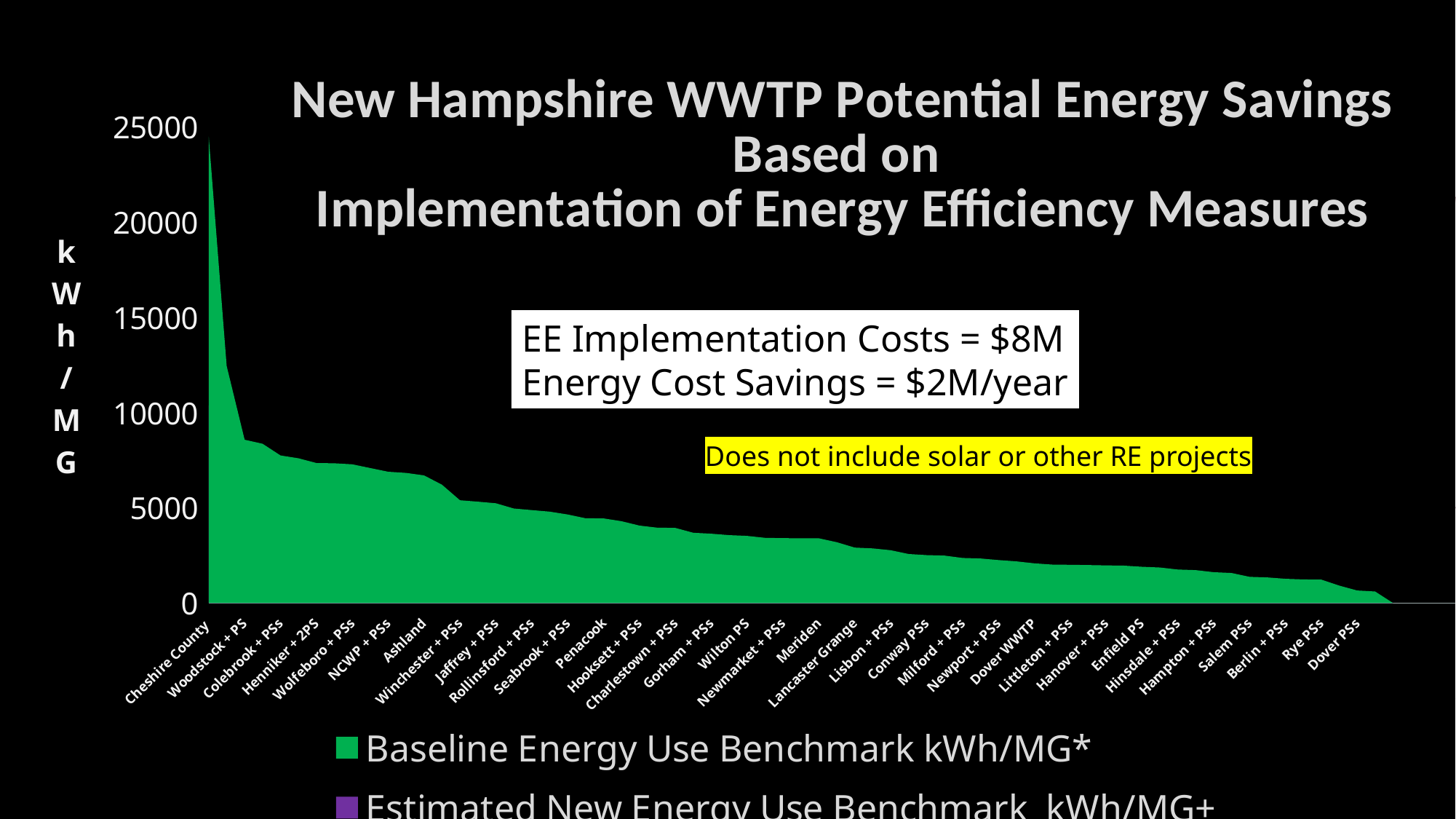
What type of chart is shown on the slide? area chart Is the value for Dover PSs greater or less than 5000? less Which category has the highest value in the chart? Cheshire County How many series does the legend list? 2 Is the value for Cheshire County greater or less than 20000? greater Is the value for Meriden greater or less than 5000? less What is the label on the vertical axis of the chart? kWh/MG Do the values rise or fall moving from left to right along the x axis? fall Which is larger, the value for Colebrook + PSs or the value for Salem PSs? Colebrook + PSs